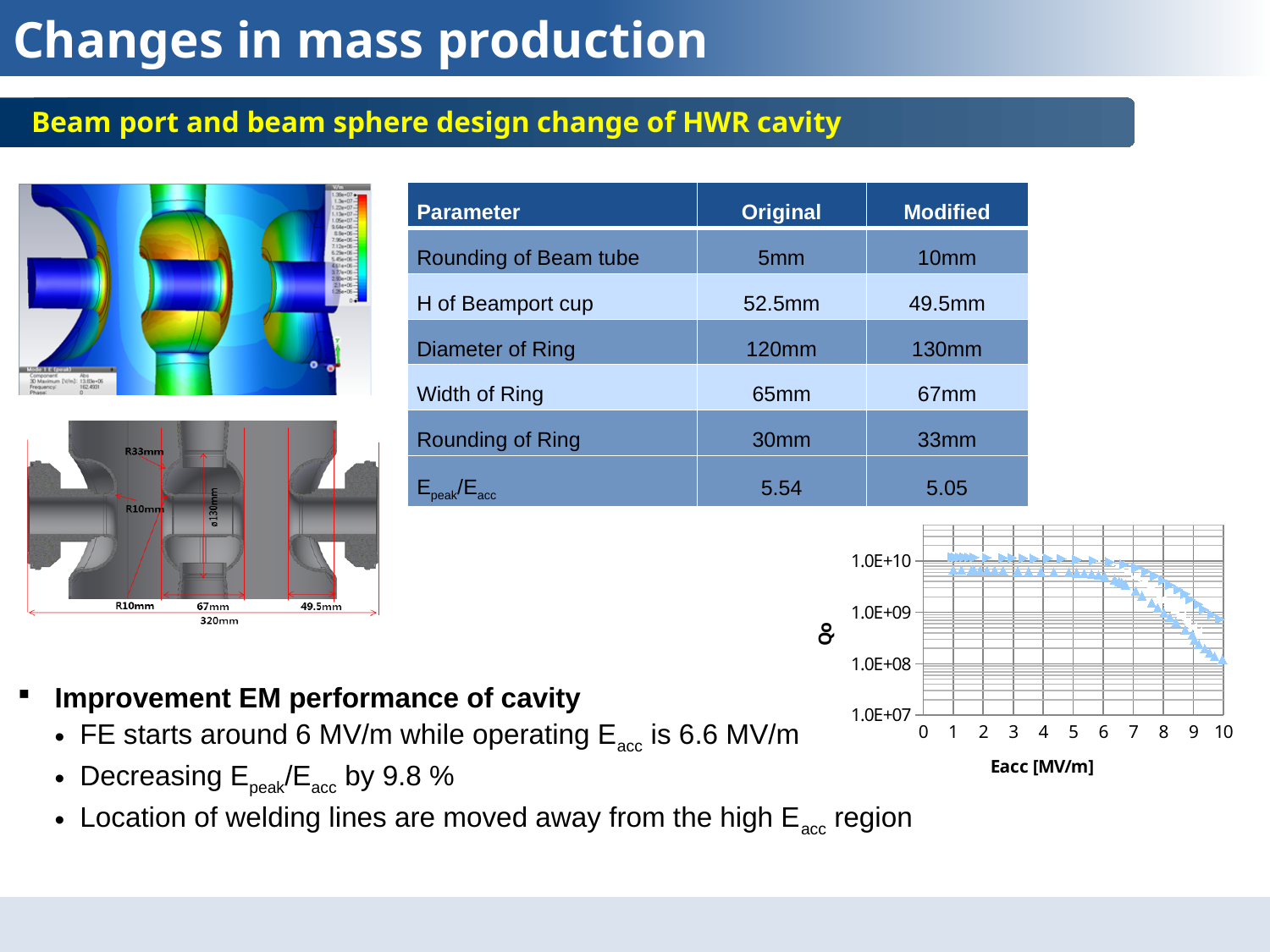
In the Q0 chart, is the value of Q0 at Eacc = 10 MV/m greater or less than 1.0E+09? less In the Q0 versus Eacc chart, does Q0 rise or fall as Eacc increases? fall What is the lowest tick value shown on the y axis of the Q0 chart? 1.0E+07 In the Q0 chart, is the value of Q0 at Eacc = 2 MV/m greater or less than 1.0E+09? greater What is the maximum value shown on the x axis of the Q0 chart? 10 In the Q0 chart, is the value of Q0 at Eacc = 4 MV/m greater or less than 1.0E+08? greater What kind of chart is shown at the bottom right of the slide? scatter chart What is the highest tick value shown on the y axis of the Q0 chart? 1.0E+10